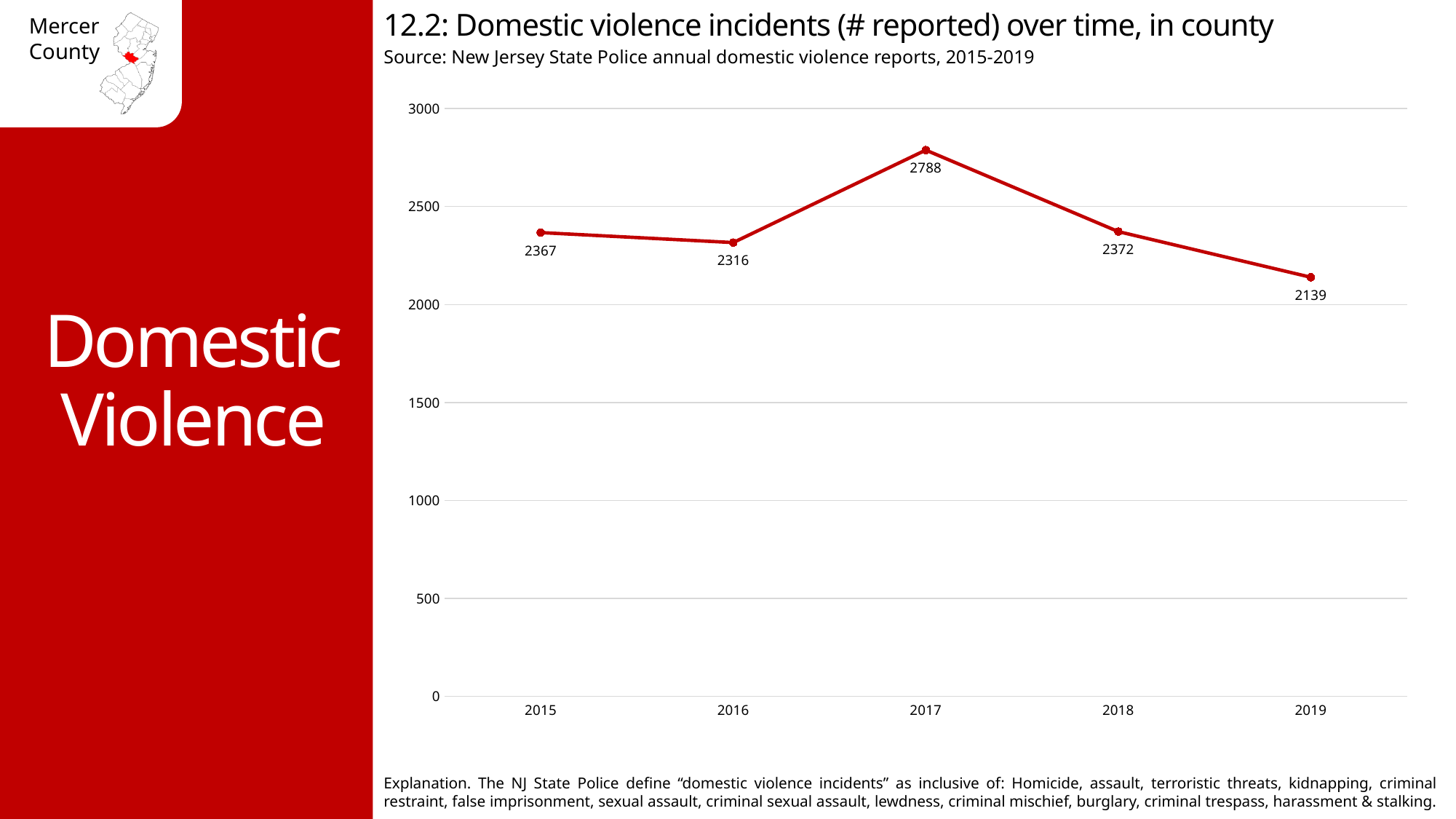
What was the number of reported domestic violence incidents in 2015? 2367 What was the number of reported domestic violence incidents in 2017? 2788 What kind of chart is shown on the slide? Line chart What is the difference between the number of incidents in 2017 and in 2016? 472 How many years are plotted on the chart? 5 Which year had more reported incidents, 2015 or 2016? 2015 What is the difference between the number of incidents in 2018 and in 2019? 233 Is the value for 2017 greater or less than 2500? greater Which year had the highest number of reported domestic violence incidents? 2017 Which year had the lowest number of reported domestic violence incidents? 2019 Did the number of reported incidents rise or fall from 2017 to 2019? Fall What was the number of reported domestic violence incidents in 2019? 2139